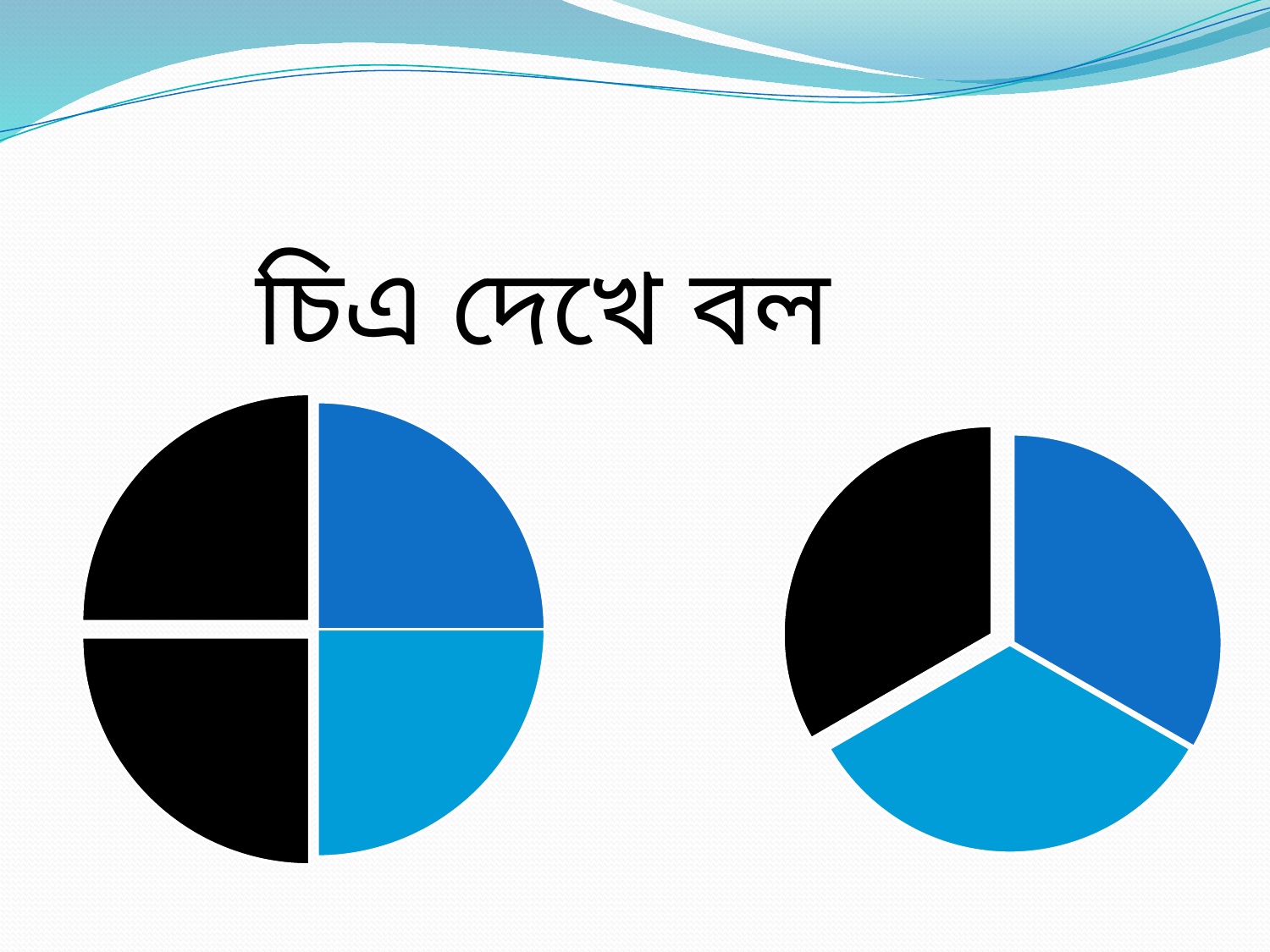
What colours are used for the slices of the pie chart on the right of the slide? black, dark blue and light blue In the pie chart on the left of the slide, is the black area larger or smaller than the light blue area? larger How many charts are shown on the slide? 2 How many slices does the pie chart on the right of the slide have? 3 Does either chart on the slide show a legend? No What kind of chart is the chart on the left of the slide? pie chart In the pie chart on the left of the slide, which colour covers the largest area? black What kind of chart is the chart on the right of the slide? pie chart